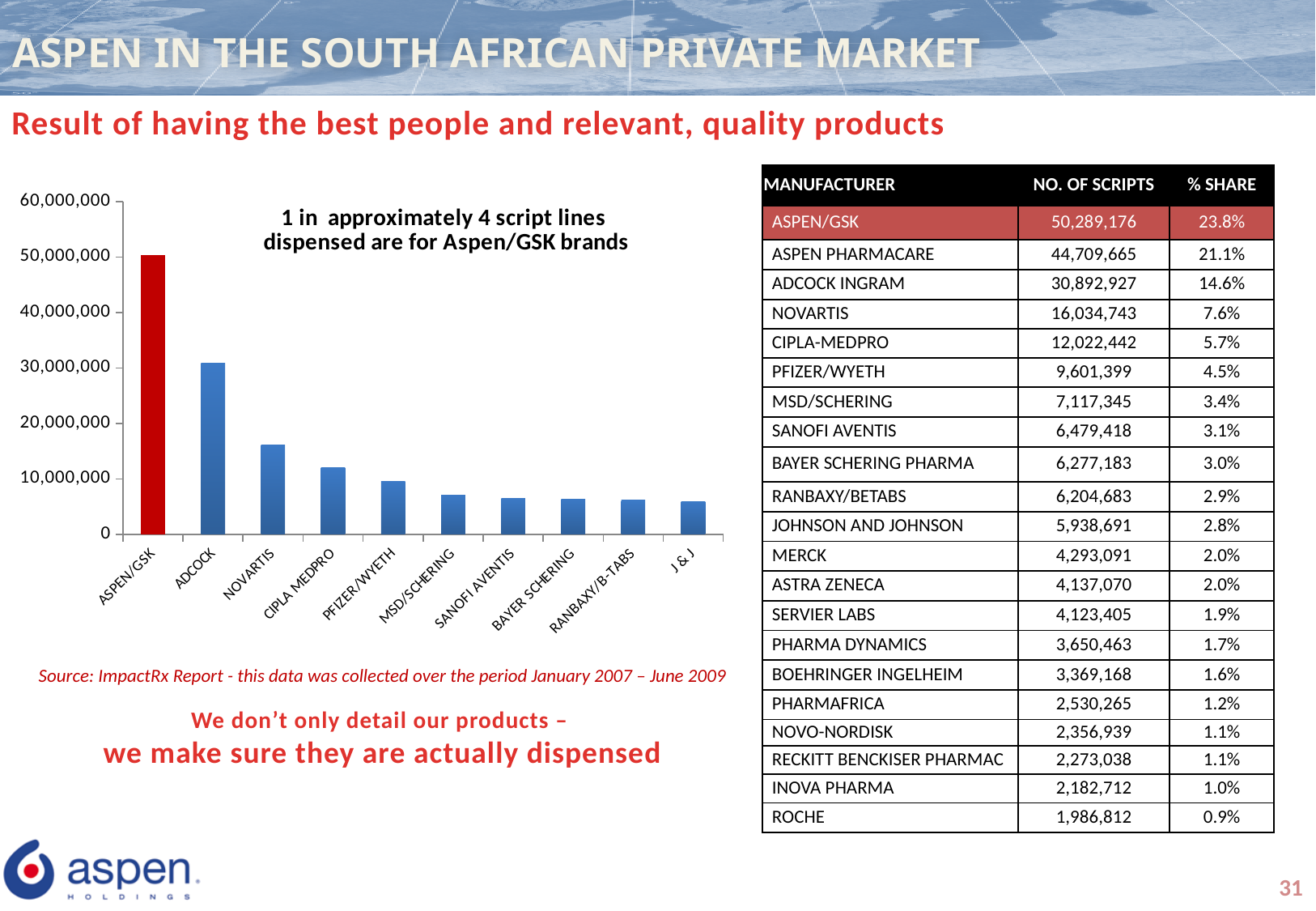
Is the value for ADCOCK on the bar chart greater or less than 20,000,000? greater How many manufacturers are plotted on the bar chart? 10 On the bar chart, which is larger, the value for ADCOCK or the value for NOVARTIS? ADCOCK Is the value for ASPEN/GSK on the bar chart greater or less than 40,000,000? greater Is the value for NOVARTIS on the bar chart greater or less than 10,000,000? greater Which manufacturer has the highest bar on the chart? ASPEN/GSK Do the bar values rise or fall moving from left to right along the x axis? fall What kind of chart is shown on the left of the slide? bar chart What is the highest tick value shown on the chart's vertical axis? 60,000,000 Which bar on the chart is coloured red rather than blue? ASPEN/GSK